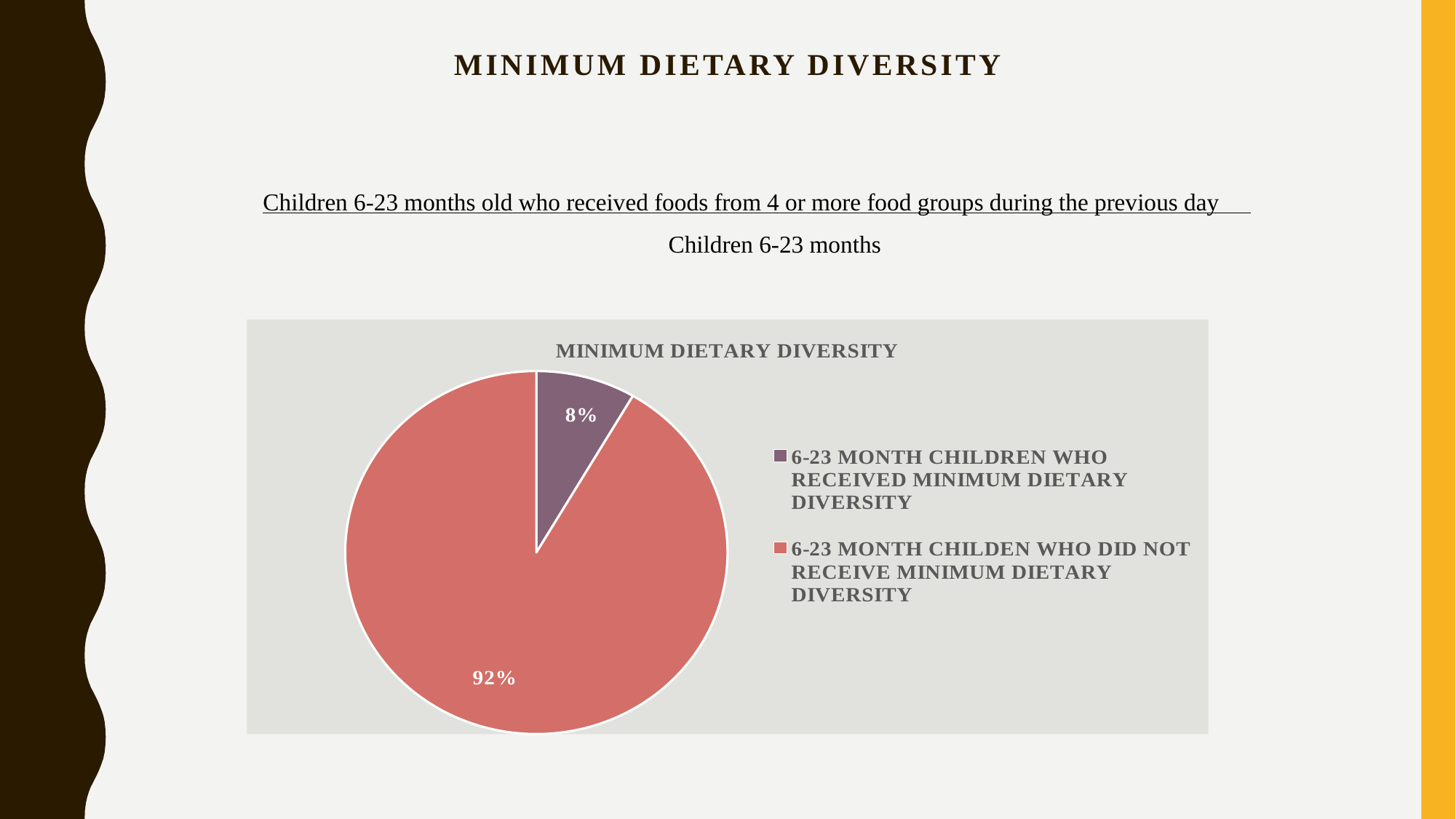
How many entries does the legend list? 2 What share of the pie is for 6-23 month children who received minimum dietary diversity? 8% What kind of chart is shown on the slide? Pie chart How many slices does the pie chart have? 2 What share of the pie is for 6-23 month children who did not receive minimum dietary diversity? 92% Which is larger: the slice for children who received minimum dietary diversity or the slice for children who did not receive it? 6-23 MONTH CHILDEN WHO DID NOT RECEIVE MINIMUM DIETARY DIVERSITY What colour is the slice for 6-23 month children who received minimum dietary diversity? Purple Which category has the largest slice of the pie? 6-23 MONTH CHILDEN WHO DID NOT RECEIVE MINIMUM DIETARY DIVERSITY What is the title of the chart? MINIMUM DIETARY DIVERSITY Which category has the smallest slice of the pie? 6-23 MONTH CHILDREN WHO RECEIVED MINIMUM DIETARY DIVERSITY What is the difference in percentage points between the slice for children who did not receive minimum dietary diversity and the slice for children who received it? 84